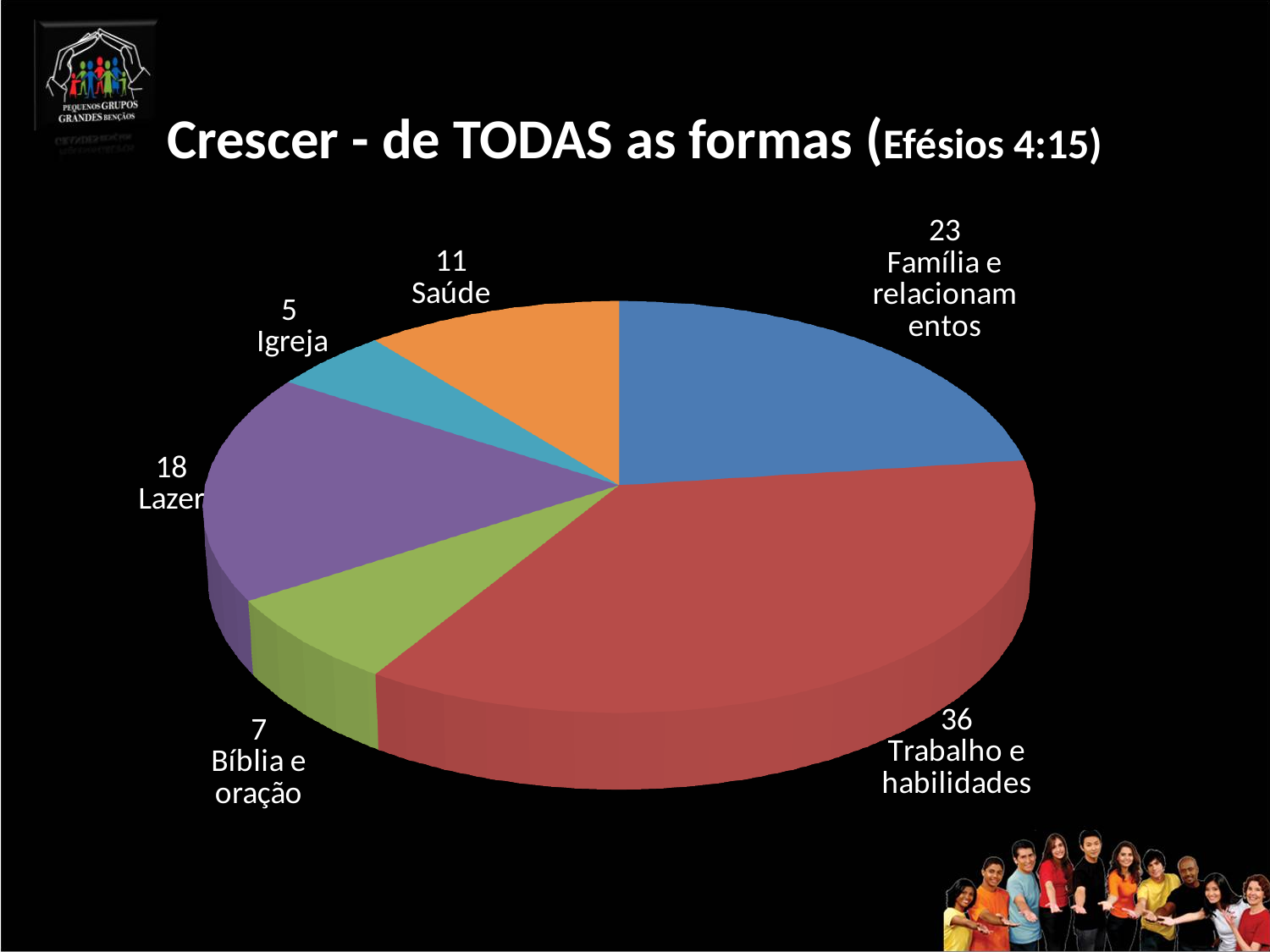
How many slices does the pie chart have? 6 What is the value for Família e relacionamentos? 23 What is the title of the slide containing the chart? Crescer - de TODAS as formas (Efésios 4:15) What is the difference between the values for Trabalho e habilidades and Família e relacionamentos? 13 What is the value for Lazer? 18 Which category has the smallest slice? Igreja Which category has the largest slice? Trabalho e habilidades What is the value for Trabalho e habilidades? 36 Which is larger, the value for Saúde or the value for Bíblia e oração? Saúde What is the value for Igreja? 5 What share of the pie does Lazer represent? 18% What type of chart is shown on the slide? pie chart